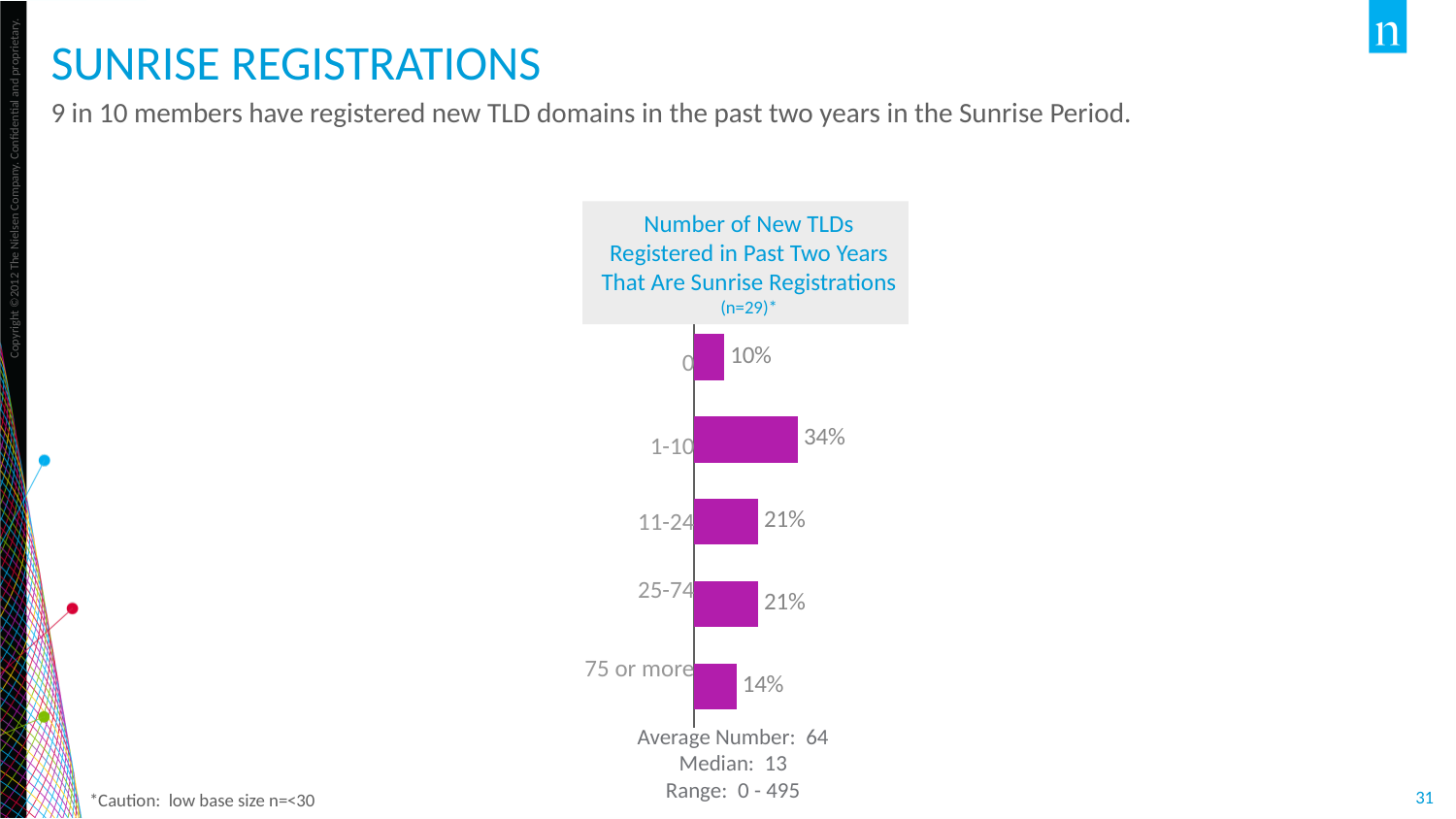
Which category has the lowest percentage? 0 What is the value for the '75 or more' category? 14% Which category has the highest percentage? 1-10 What kind of chart is shown on the slide? Bar chart What is the difference between the '1-10' and '75 or more' values? 20% Which is larger, the value for '0' or the value for '75 or more'? 75 or more What is the sample size (n) stated in the chart title? 29 How many categories are shown in the chart? 5 What percentage of members registered 1-10 new TLDs as sunrise registrations? 34% What is the average number stated below the chart? 64 What is the value for the '0' category? 10% What is the value for the '11-24' category? 21%